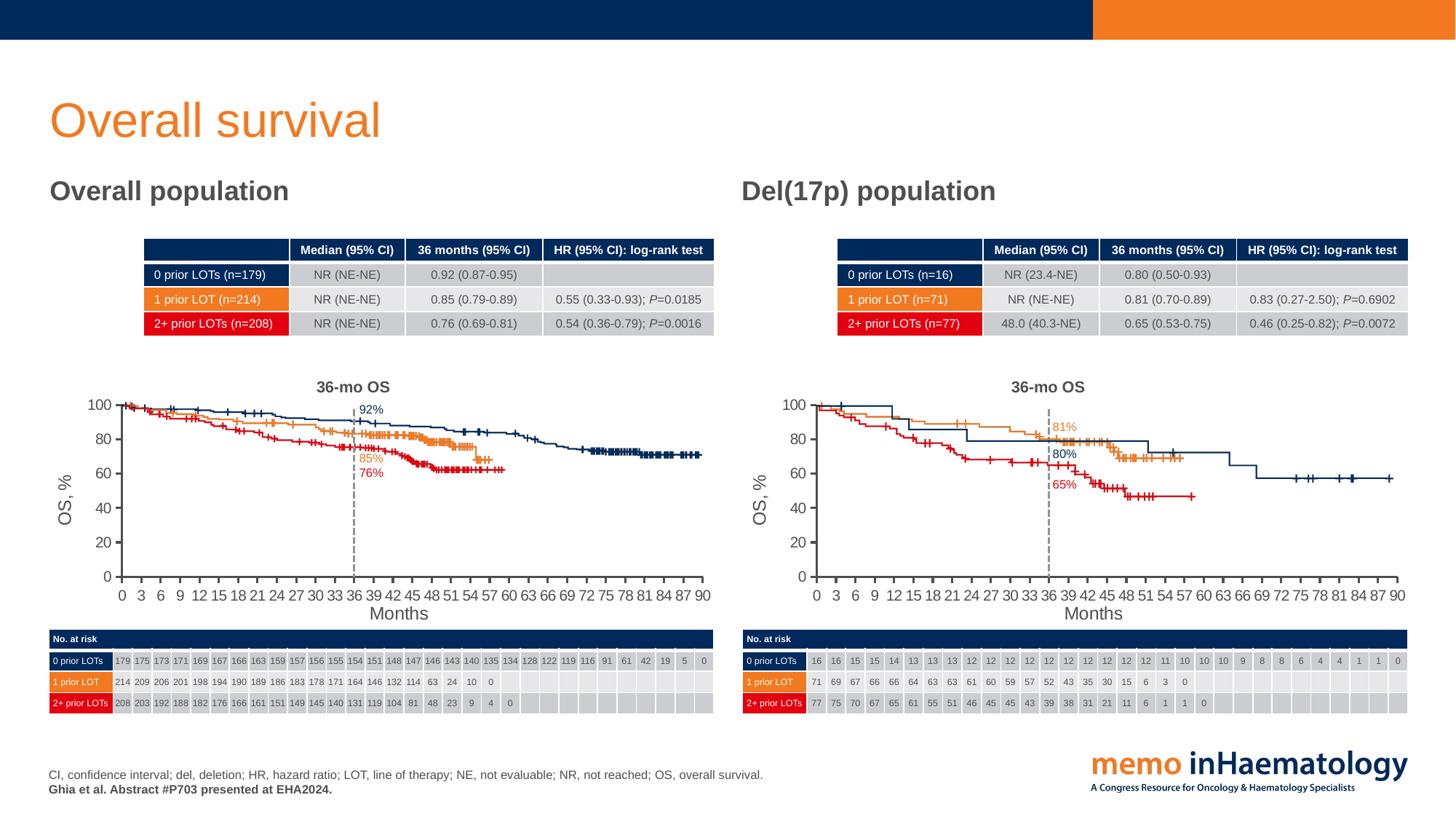
In the Overall population chart, is the 36-month OS for the 1 prior LOT group greater or less than 80? greater In the Overall population chart, which group has the highest 36-month OS? 0 prior LOTs What kind of chart is used to show overall survival on this slide? Line chart (Kaplan-Meier curve) In the Del(17p) population chart, what is the 36-month OS for the 1 prior LOT group? 81% In the Del(17p) population chart, which group has the lowest 36-month OS? 2+ prior LOTs In the Overall population chart, what is the 36-month OS for the 0 prior LOTs group? 92% In the Del(17p) population chart, what is the 36-month OS for the 2+ prior LOTs group? 65% In the Overall population chart, what is the 36-month OS for the 2+ prior LOTs group? 76% In the Overall population chart, what is the difference between the 36-month OS of the 0 prior LOTs group and the 2+ prior LOTs group? 16% In the Del(17p) population chart, what is the difference between the 36-month OS of the 1 prior LOT group and the 2+ prior LOTs group? 16% In the Overall population chart, how many patients were at risk in the 0 prior LOTs group at month 0? 179 In the Del(17p) population chart, how many patients were at risk in the 2+ prior LOTs group at month 0? 77